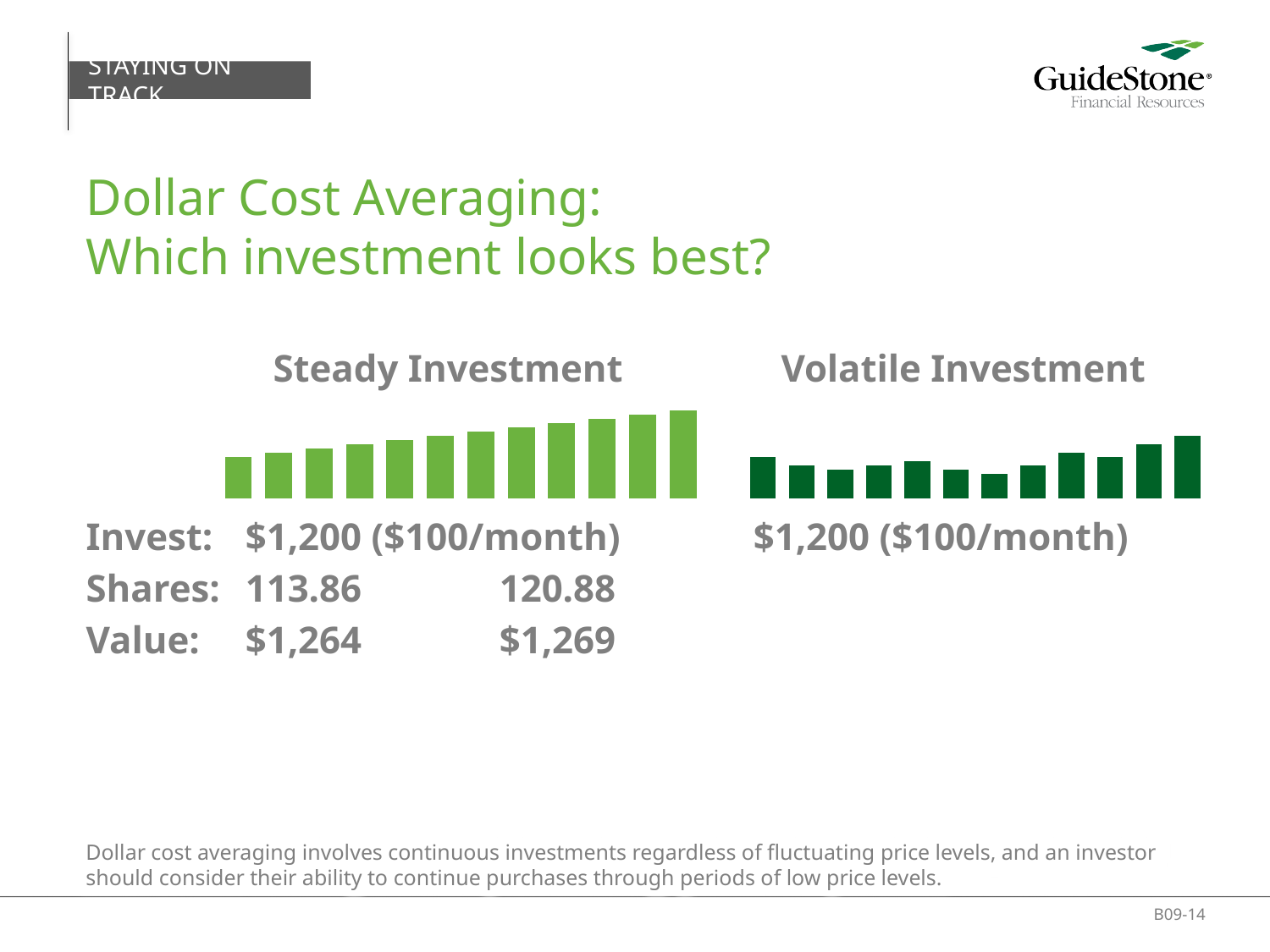
According to the slide, how many shares does the Volatile Investment end up with? 120.88 According to the slide, how many shares does the Steady Investment end up with? 113.86 What colour are the bars in the Volatile Investment chart? dark green According to the slide, what is the final value of the Volatile Investment? $1,269 What kind of chart is used for the Steady Investment? bar chart In the Steady Investment chart, which bar is the tallest? the last (rightmost) bar In the Steady Investment chart, do the bars rise or fall from left to right? rise In the Volatile Investment chart, is the last bar taller or shorter than the first bar? taller In the Volatile Investment chart, which bar is the tallest? the last (rightmost) bar How many bars does the Steady Investment chart have? 12 How many bars does the Volatile Investment chart have? 12 In the Steady Investment chart, which bar is the shortest? the first (leftmost) bar